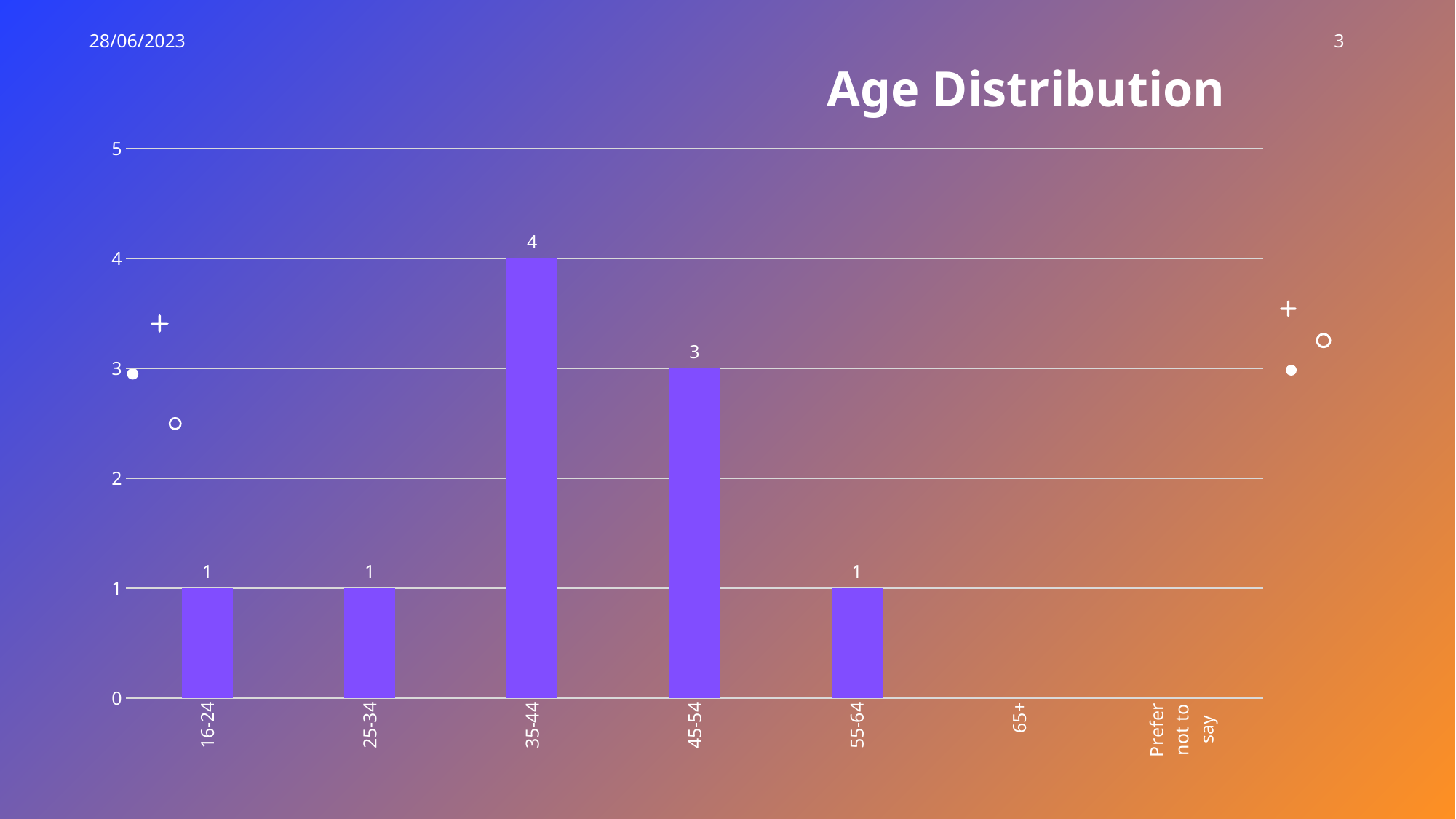
What kind of chart is shown on the slide? Bar chart What is the value for the 16-24 age group? 1 Which age group has the highest value? 35-44 How many age categories are shown on the x axis? 7 What is the difference between the values for 35-44 and 45-54? 1 What is the value for the 35-44 age group? 4 What is the highest value shown on the y axis? 5 What is the value for the 55-64 age group? 1 What is the value for the 45-54 age group? 3 Which is larger, the value for 45-54 or the value for 55-64? 45-54 What is the difference between the values for 35-44 and 25-34? 3 What is the title of the chart? Age Distribution